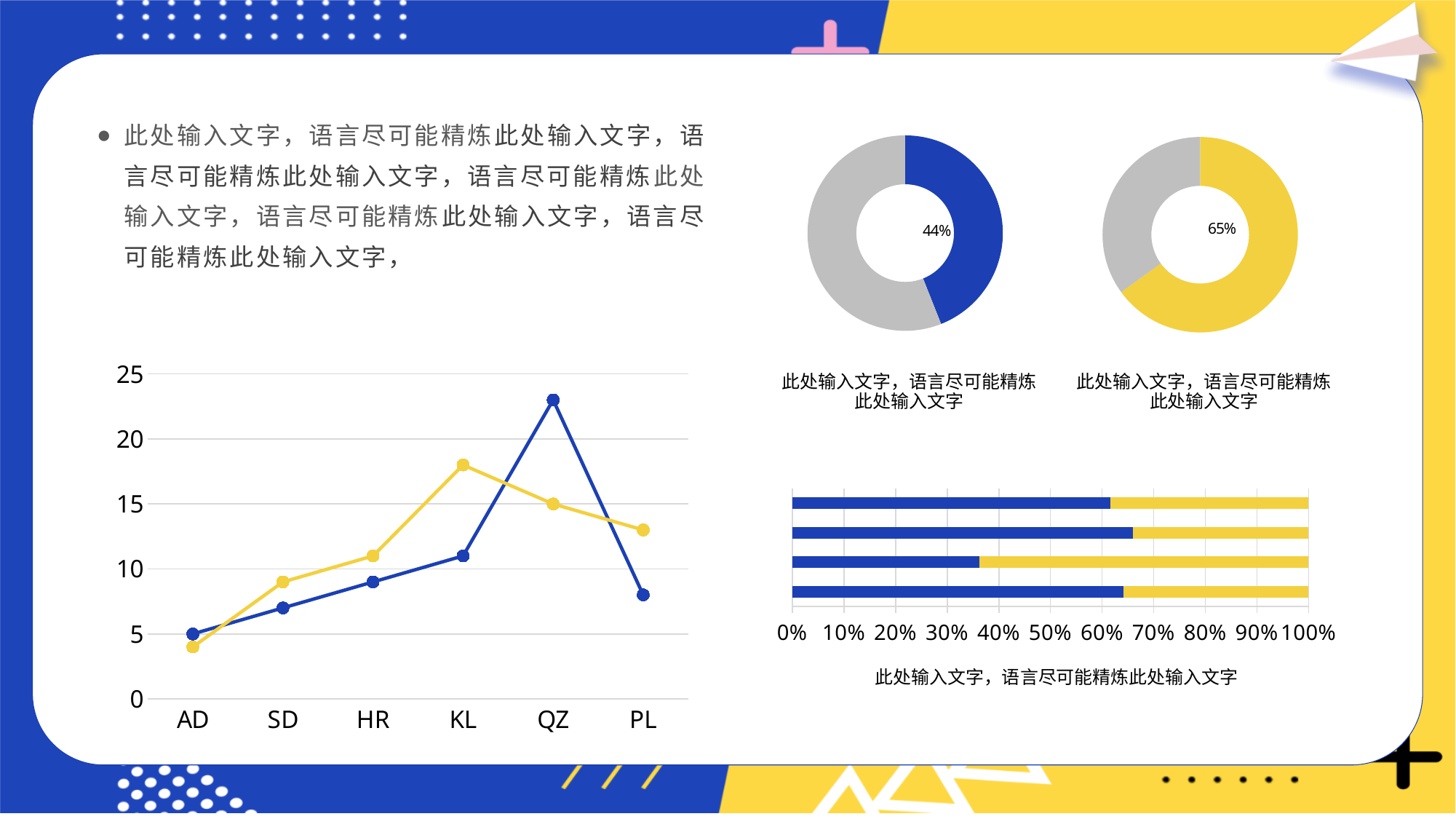
In the line chart at the bottom left, what is the value of the blue series at AD? 5 What percentage is shown in the right donut chart (yellow) at the top right of the slide? 65% In the line chart at the bottom left, at which category does the yellow series reach its highest value? KL In the horizontal stacked bar chart at the bottom right, is the blue segment of the third bar from the top greater or less than 40%? less How many bars are there in the horizontal stacked bar chart at the bottom right of the slide? 4 In the line chart at the bottom left, at which category does the blue series reach its highest value? QZ In the line chart at the bottom left, how many categories are shown on the x axis? 6 What kind of chart is the chart at the bottom left of the slide with categories AD to PL? line chart In the line chart at the bottom left, at QZ, which series has the larger value, blue or yellow? blue In the line chart at the bottom left, is the value of the blue series at QZ greater or less than 20? greater In the line chart at the bottom left, is the value of the yellow series at KL greater or less than 15? greater What percentage is shown in the left donut chart (blue) at the top right of the slide? 44%